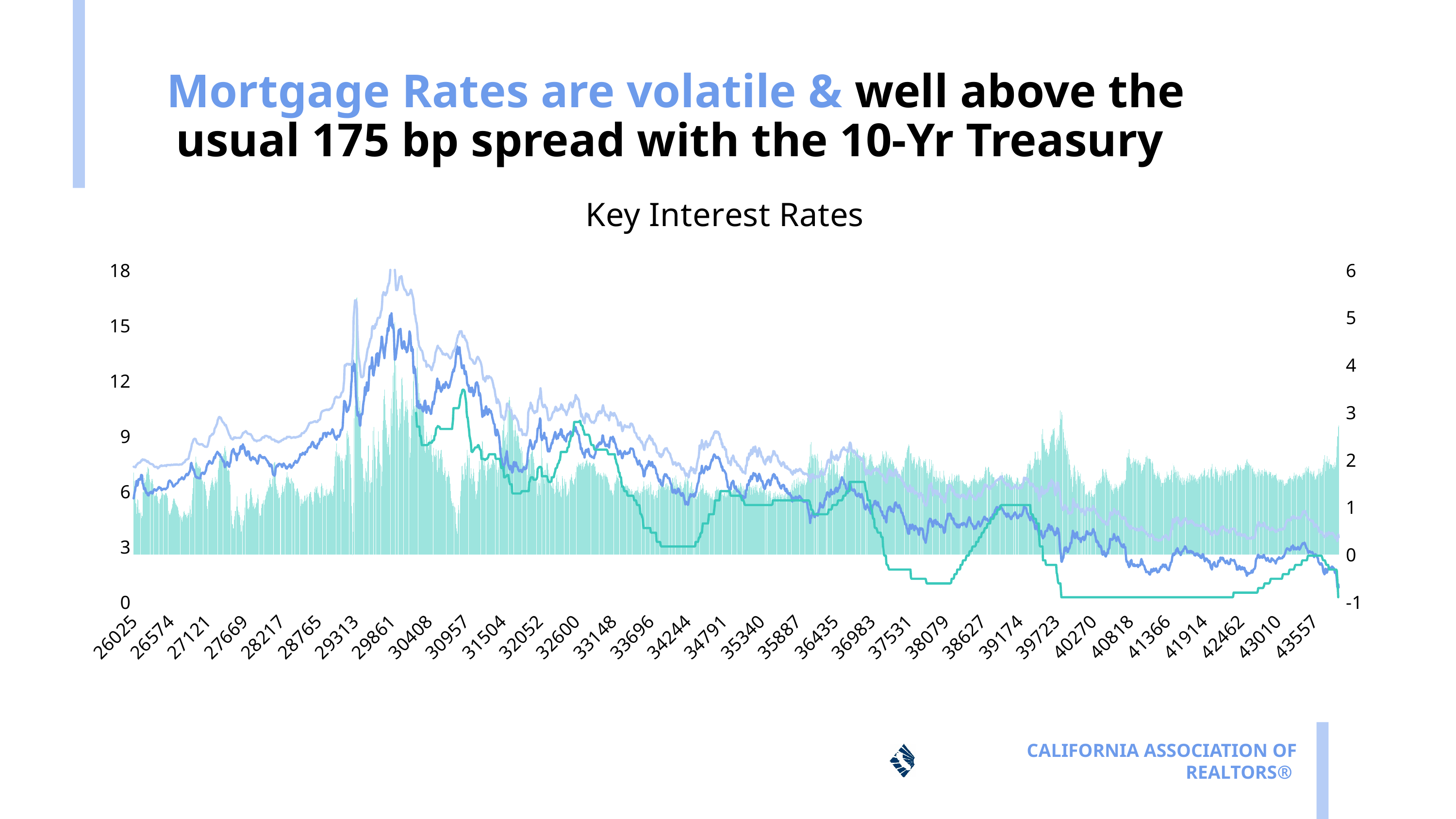
On the left-hand axis scale, is the peak of the light blue line greater or less than 15? greater What is the title of the chart? Key Interest Rates Near which x-axis label do the blue lines reach their highest point? 29861 What is the lowest tick value shown on the right vertical axis? -1 How many labels are printed along the x axis? 33 From its peak near 29861 to the right end of the chart, does the light blue line generally rise or fall? fall What is the last label on the x axis? 43557 On the right-hand axis scale, is the teal step line at the far right end of the chart greater or less than 3? less What is the highest tick value shown on the left vertical axis? 18 How many vertical axes does the chart have? 2 What is the first label on the x axis? 26025